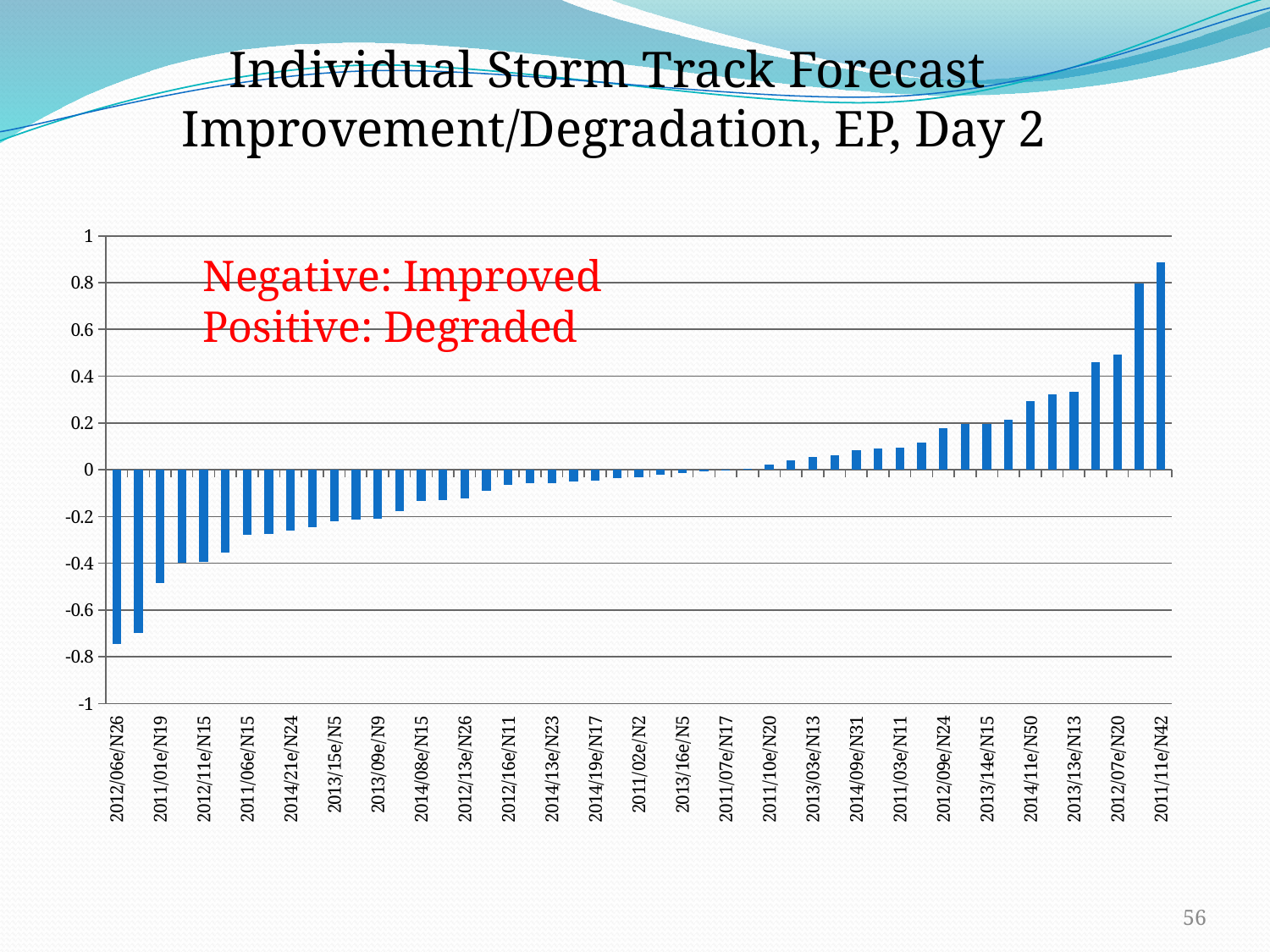
Which has the larger value, 2012/06e/N26 or 2011/01e/N19? 2011/01e/N19 Do the bar values rise or fall moving from left to right along the x axis? rise What is the title of the chart? Individual Storm Track Forecast Improvement/Degradation, EP, Day 2 According to the red annotation on the chart, what does a negative value indicate? Improved Is the value for 2012/06e/N26 greater or less than -0.6? less Is the value for 2011/01e/N19 greater or less than -0.4? less Which has the larger value, 2011/11e/N42 or 2012/07e/N20? 2011/11e/N42 Which storm has the highest value on the chart? 2011/11e/N42 Is the value for 2012/07e/N20 greater or less than 0.4? greater What kind of chart is shown on the slide? bar chart